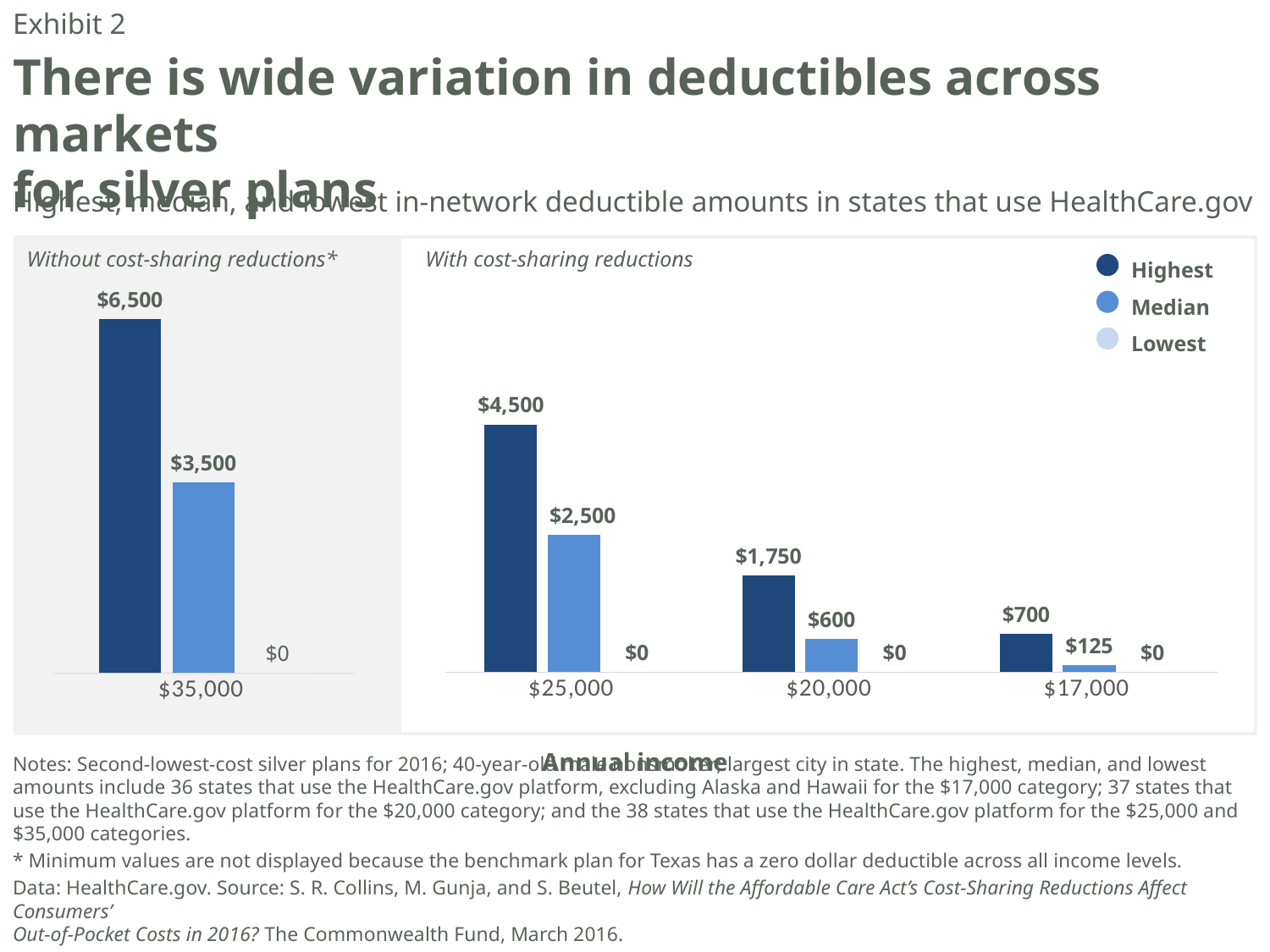
In the 'With cost-sharing reductions' panel, is the Median deductible at $25,000 larger or smaller than the Highest deductible at $20,000? larger In the 'With cost-sharing reductions' panel, which income level has the lowest Median deductible? $17,000 In the 'Without cost-sharing reductions' panel, what is the Median deductible at the $35,000 income level? $3,500 In the 'With cost-sharing reductions' panel, what is the difference between the Highest and Median deductibles at the $20,000 income level? $1,150 In the 'With cost-sharing reductions' panel, which income level has the highest Highest deductible? $25,000 In the 'With cost-sharing reductions' panel, what is the Highest deductible at the $20,000 income level? $1,750 What is the difference between the Highest deductible at $35,000 (without cost-sharing reductions) and the Highest deductible at $25,000 (with cost-sharing reductions)? $2,000 In the 'With cost-sharing reductions' panel, what is the Median deductible at the $17,000 income level? $125 What kind of chart is shown on the slide? bar chart How many income levels are shown in the 'With cost-sharing reductions' panel? 3 In the 'With cost-sharing reductions' panel, what is the Highest deductible at the $25,000 income level? $4,500 How many series does the legend list? 3